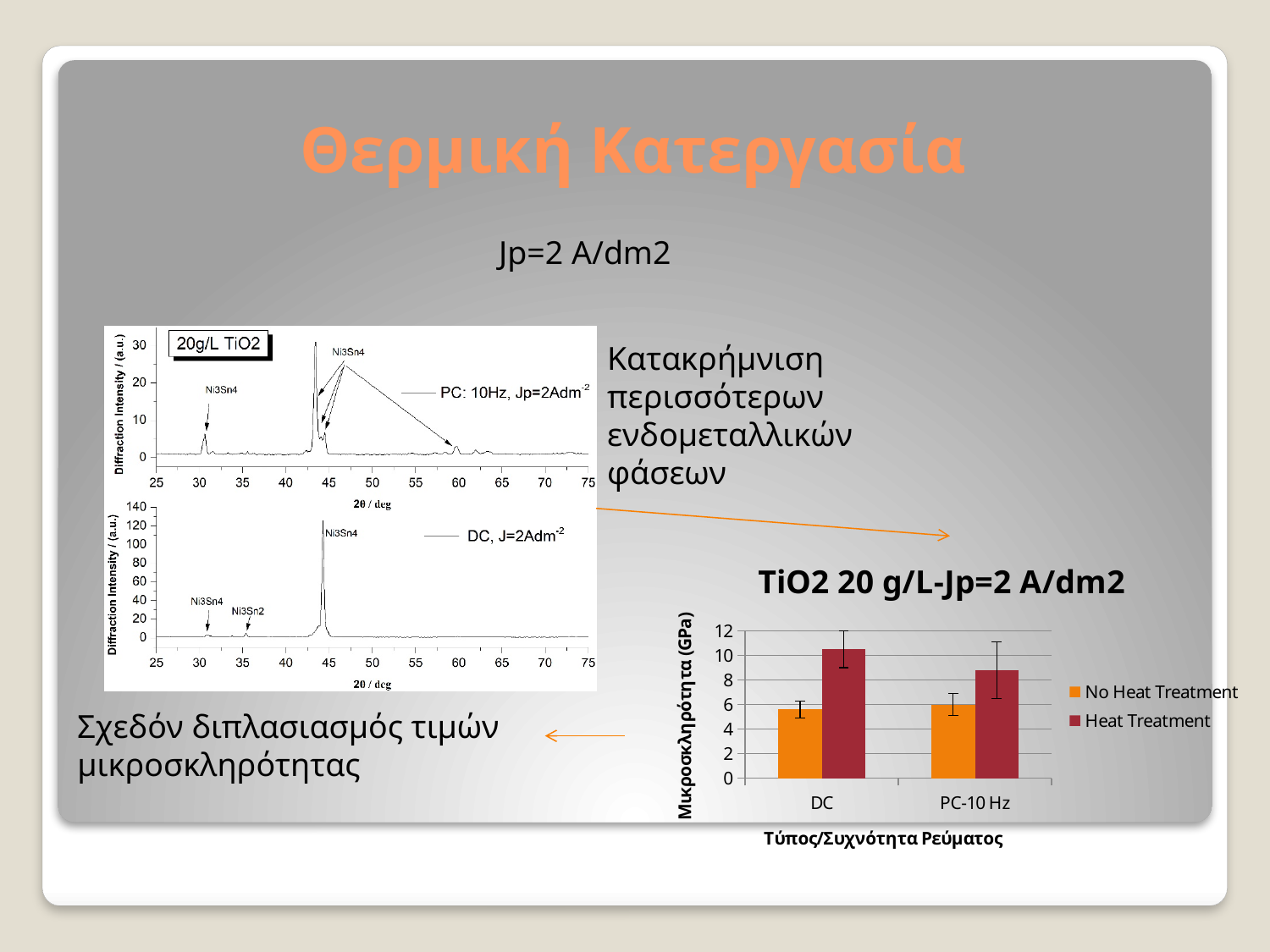
In the chart titled "TiO2 20 g/L-Jp=2 A/dm2", which colour represents the Heat Treatment series? dark red In the chart titled "TiO2 20 g/L-Jp=2 A/dm2", is the Heat Treatment value for PC-10 Hz greater or less than 6? greater In the chart titled "TiO2 20 g/L-Jp=2 A/dm2", what is the label of the y axis? Μικροσκληρότητα (GPa) In the chart titled "TiO2 20 g/L-Jp=2 A/dm2", which category and series has the highest bar? DC, Heat Treatment In the chart titled "TiO2 20 g/L-Jp=2 A/dm2", is the No Heat Treatment value for DC greater or less than 8? less In the chart titled "TiO2 20 g/L-Jp=2 A/dm2", is the No Heat Treatment value for PC-10 Hz greater or less than 4? greater In the chart titled "TiO2 20 g/L-Jp=2 A/dm2", for the DC category, which is larger: No Heat Treatment or Heat Treatment? Heat Treatment In the chart titled "TiO2 20 g/L-Jp=2 A/dm2", for the Heat Treatment series, which category has the larger value: DC or PC-10 Hz? DC In the chart titled "TiO2 20 g/L-Jp=2 A/dm2", what kind of chart is shown? bar chart In the chart titled "TiO2 20 g/L-Jp=2 A/dm2", how many categories are shown on the x axis? 2 In the chart titled "TiO2 20 g/L-Jp=2 A/dm2", how many series does the legend list? 2